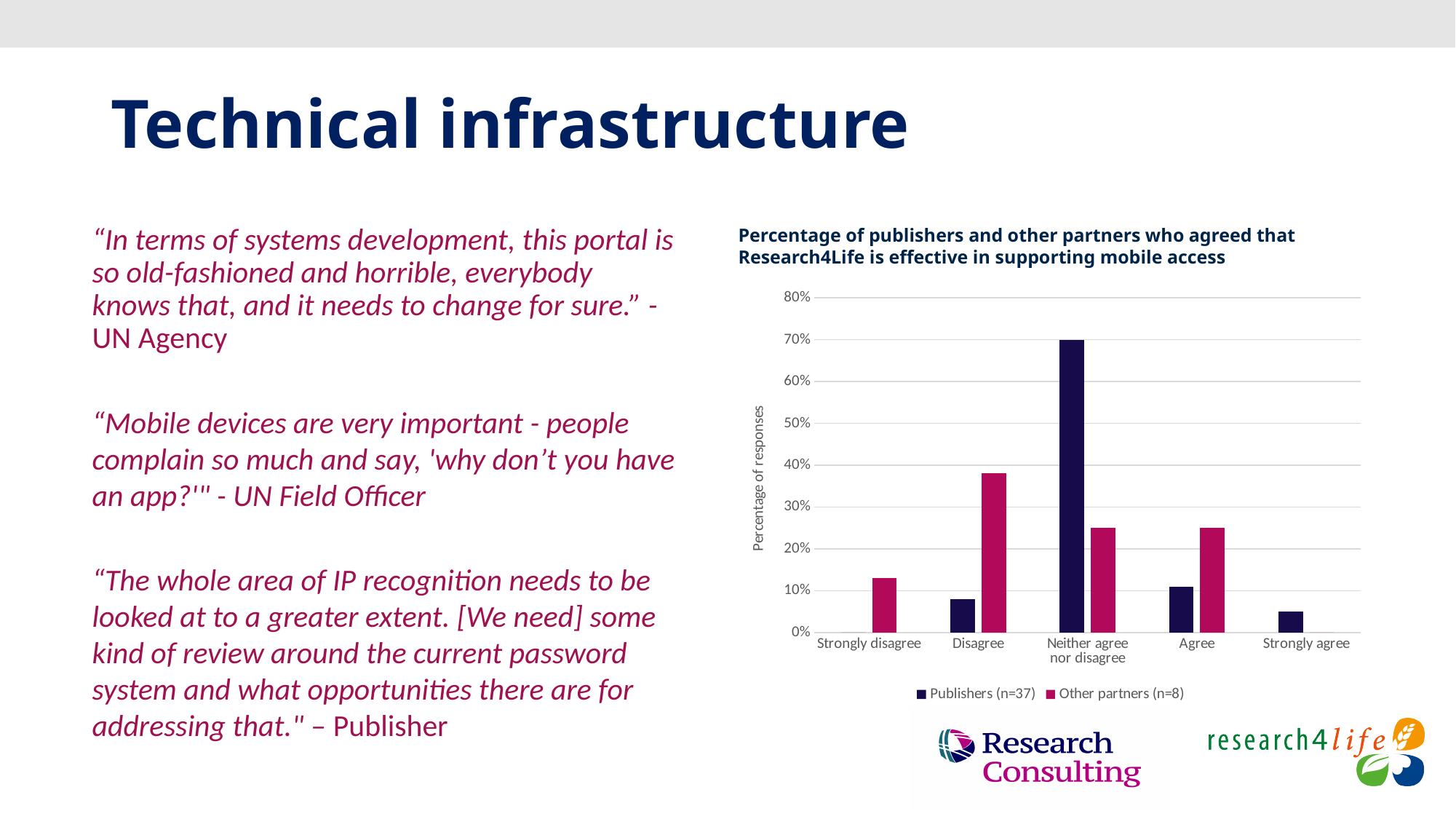
Which is larger in the Disagree category: Publishers (n=37) or Other partners (n=8)? Other partners (n=8) Is the value for Other partners (n=8) in the Strongly disagree category greater or less than 20%? less Which is larger in the Neither agree nor disagree category: Publishers (n=37) or Other partners (n=8)? Publishers (n=37) What is the label of the chart's y axis? Percentage of responses What kind of chart is shown on the slide? bar chart Which response category has the highest value for Other partners (n=8)? Disagree Is the value for Publishers (n=37) in the Agree category greater or less than 20%? less Is the value for Other partners (n=8) in the Disagree category greater or less than 30%? greater Which response category has the highest value for Publishers (n=37)? Neither agree nor disagree How many response categories are shown on the x axis of the chart? 5 How many series does the chart legend list? 2